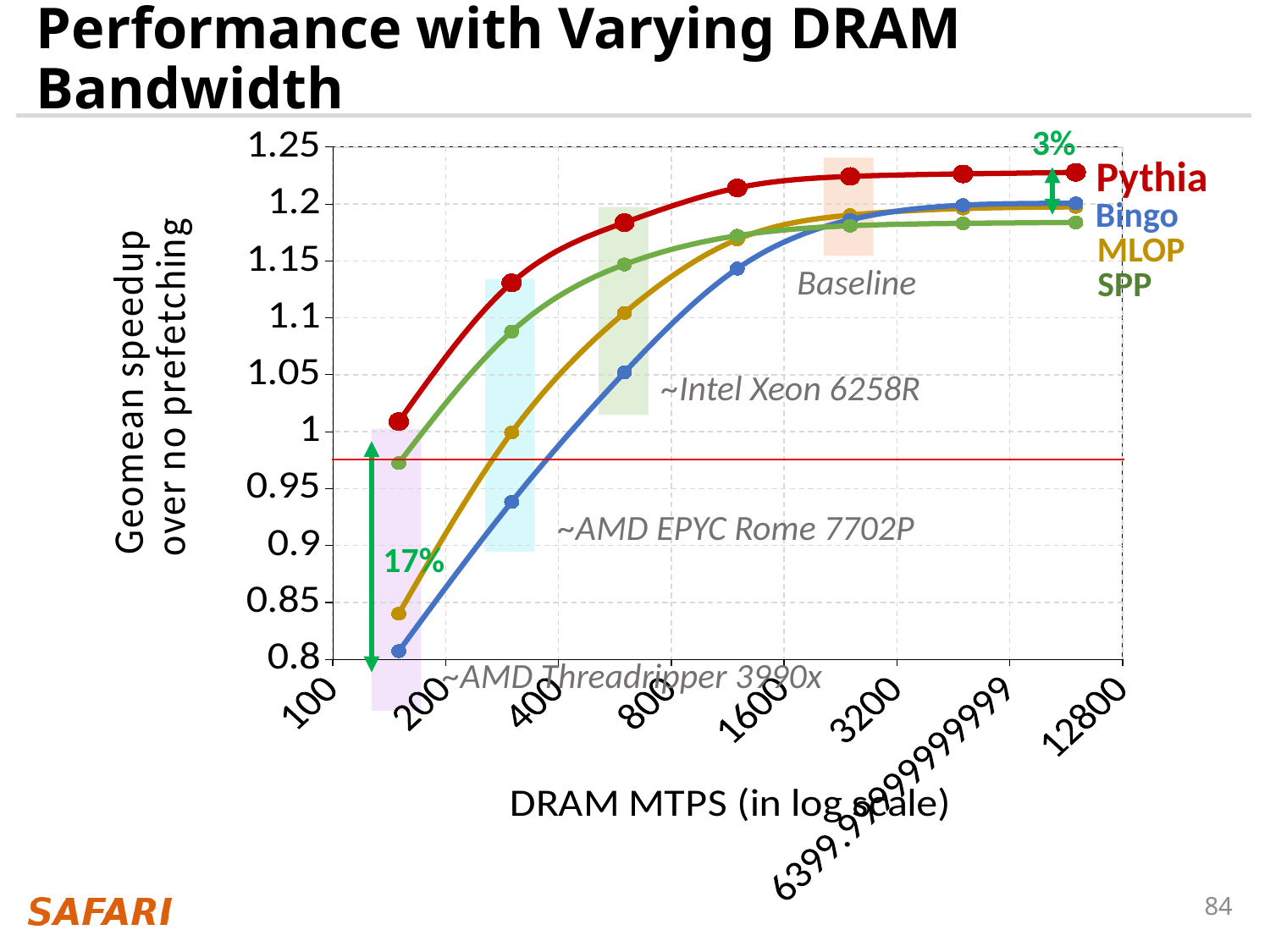
Do the speedup values rise or fall as DRAM MTPS increases along the x axis? rise At the lowest DRAM bandwidth point, is the value for MLOP or Bingo larger? MLOP Is the value for SPP at the lowest DRAM bandwidth point greater or less than 1? less Is the value for Bingo at the lowest DRAM bandwidth point greater or less than 0.85? less How many data points are plotted for the Pythia series? 7 What is the title of the x axis? DRAM MTPS (in log scale) Which series has the lowest value at the highest DRAM bandwidth point? SPP Which series has the lowest value at the lowest DRAM bandwidth point? Bingo Which series has the highest value at the lowest DRAM bandwidth point? Pythia Is the value for Pythia at the highest DRAM bandwidth point greater or less than 1.2? greater How many series does the chart's legend list? 4 What kind of chart is shown on the slide? line chart